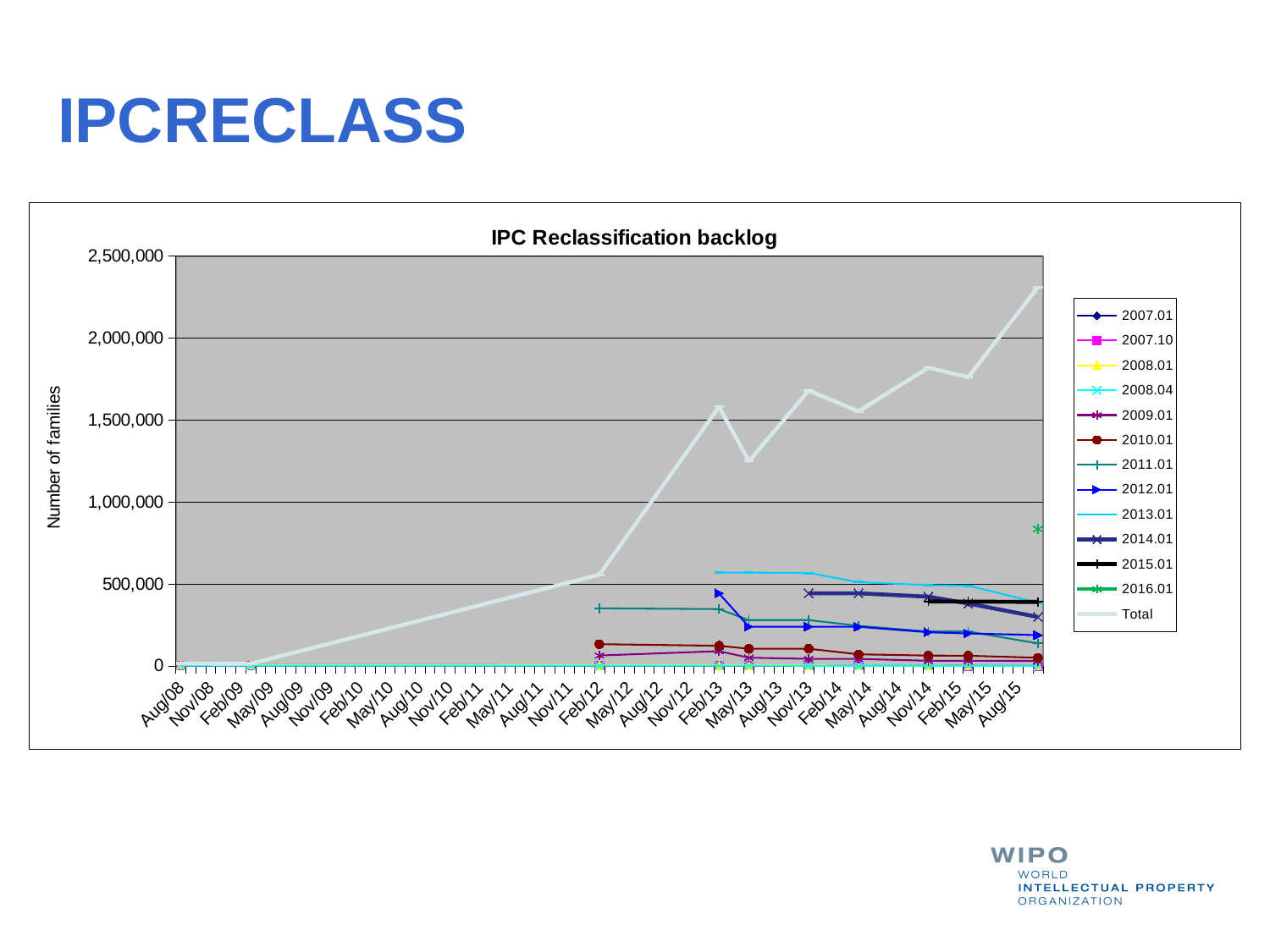
What kind of chart is shown on the slide? Line chart How many series does the legend list? 13 Is the value of the 2010.01 series at Feb/12 greater or less than 500,000? less What is the title of the chart? IPC Reclassification backlog Is the value of the Total series at Aug/15 greater or less than 2,000,000? greater Does the Total series generally rise or fall from Aug/08 to Aug/15? rise Which of the two is larger at Aug/15: the Total series or the 2014.01 series? Total Is the value of the 2013.01 series at Feb/13 greater or less than 500,000? greater Which series reaches the highest value on the chart? Total What is the label of the vertical axis? Number of families